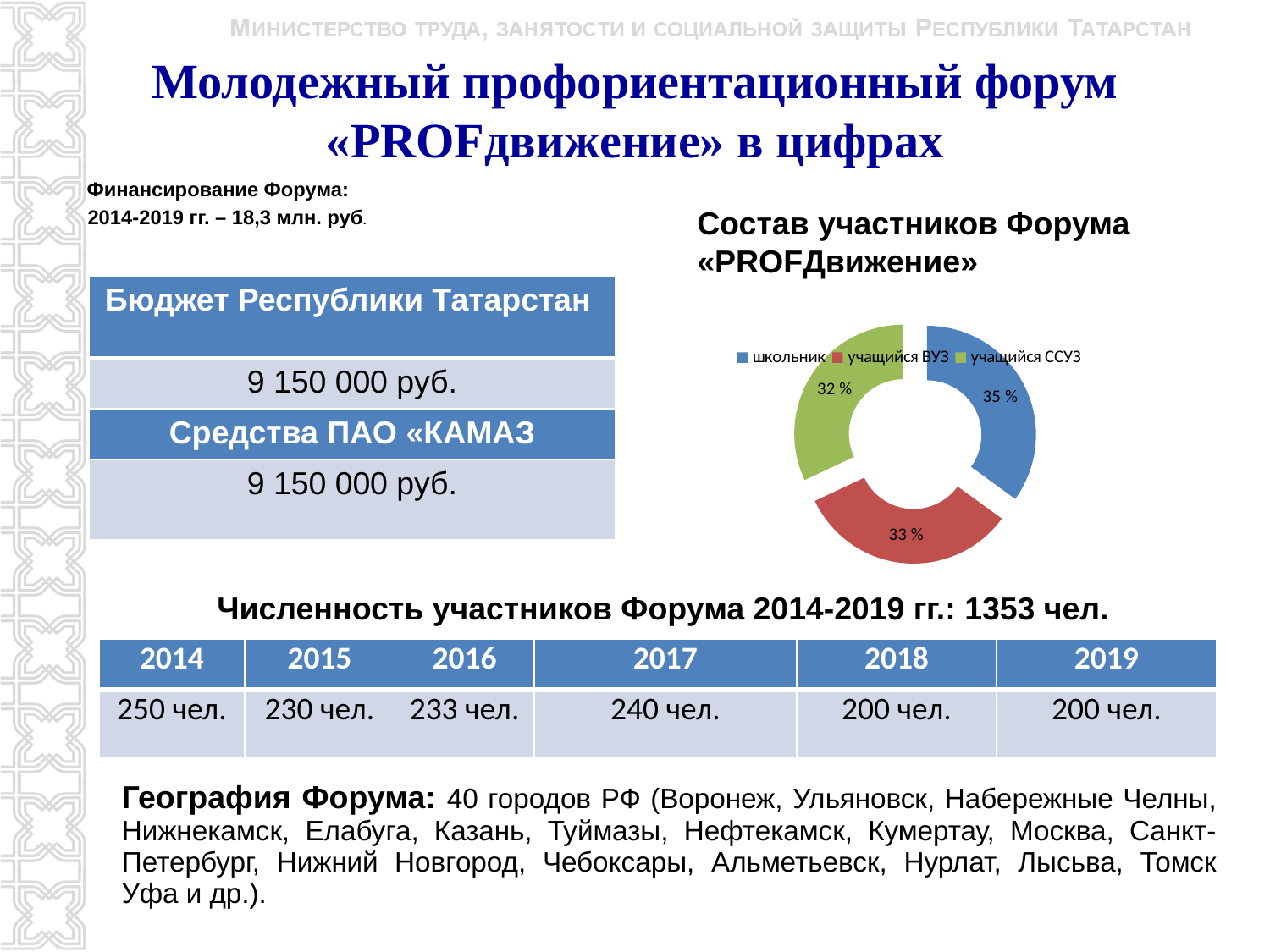
What share of the doughnut chart is labelled «учащийся ВУЗ»? 33 % How many entries does the legend of the doughnut chart list? 3 Which category has the largest share in the doughnut chart? школьник By how many percentage points does the «школьник» share exceed the «учащийся ССУЗ» share? 3 What is the title of the chart on the slide? Состав участников Форума «PROFДвижение» What share of the doughnut chart is labelled «школьник»? 35 % Which is larger in the doughnut chart: the share for «школьник» or for «учащийся ВУЗ»? школьник What share of the doughnut chart is labelled «учащийся ССУЗ»? 32 % What colour represents «школьник» in the doughnut chart? blue How many categories are shown in the doughnut chart? 3 What kind of chart is used to show the composition of forum participants? doughnut (pie) chart Which category has the smallest share in the doughnut chart? учащийся ССУЗ